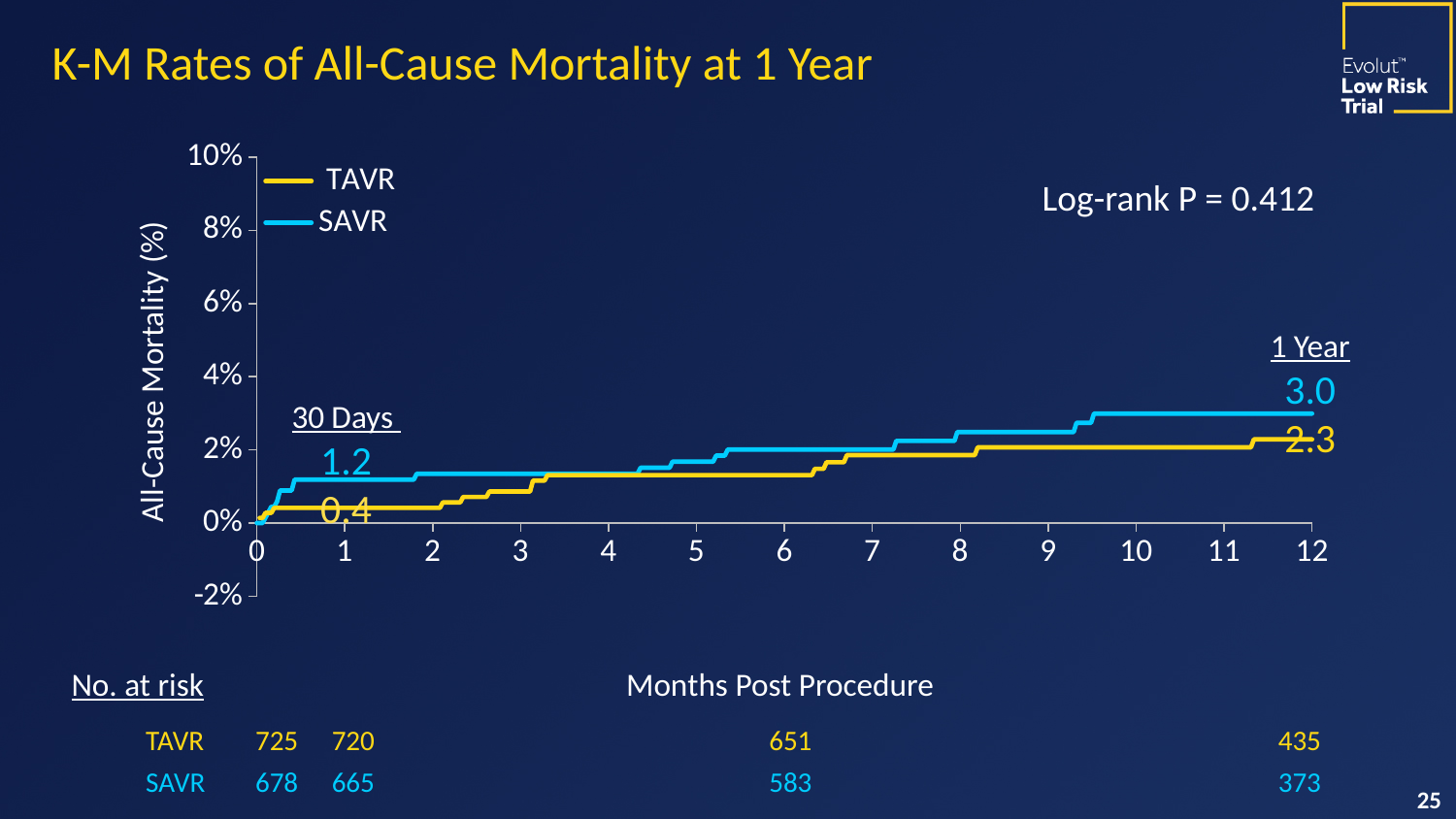
What is the difference between the SAVR and TAVR all-cause mortality rates at 30 days? 0.8 What is the all-cause mortality rate for SAVR at 1 year? 3.0 What is the log-rank P value shown on the chart? 0.412 What is the title of the chart? K-M Rates of All-Cause Mortality at 1 Year What is the all-cause mortality rate for TAVR at 30 days? 0.4 What is the difference between the SAVR and TAVR all-cause mortality rates at 1 year? 0.7 Which group has the higher all-cause mortality rate at 1 year, TAVR or SAVR? SAVR What is the all-cause mortality rate for SAVR at 30 days? 1.2 Do the all-cause mortality curves rise or fall as months post procedure increase? rise How many series does the legend list? 2 What is the all-cause mortality rate for TAVR at 1 year? 2.3 Is the SAVR all-cause mortality rate at 1 year greater or less than 4%? less